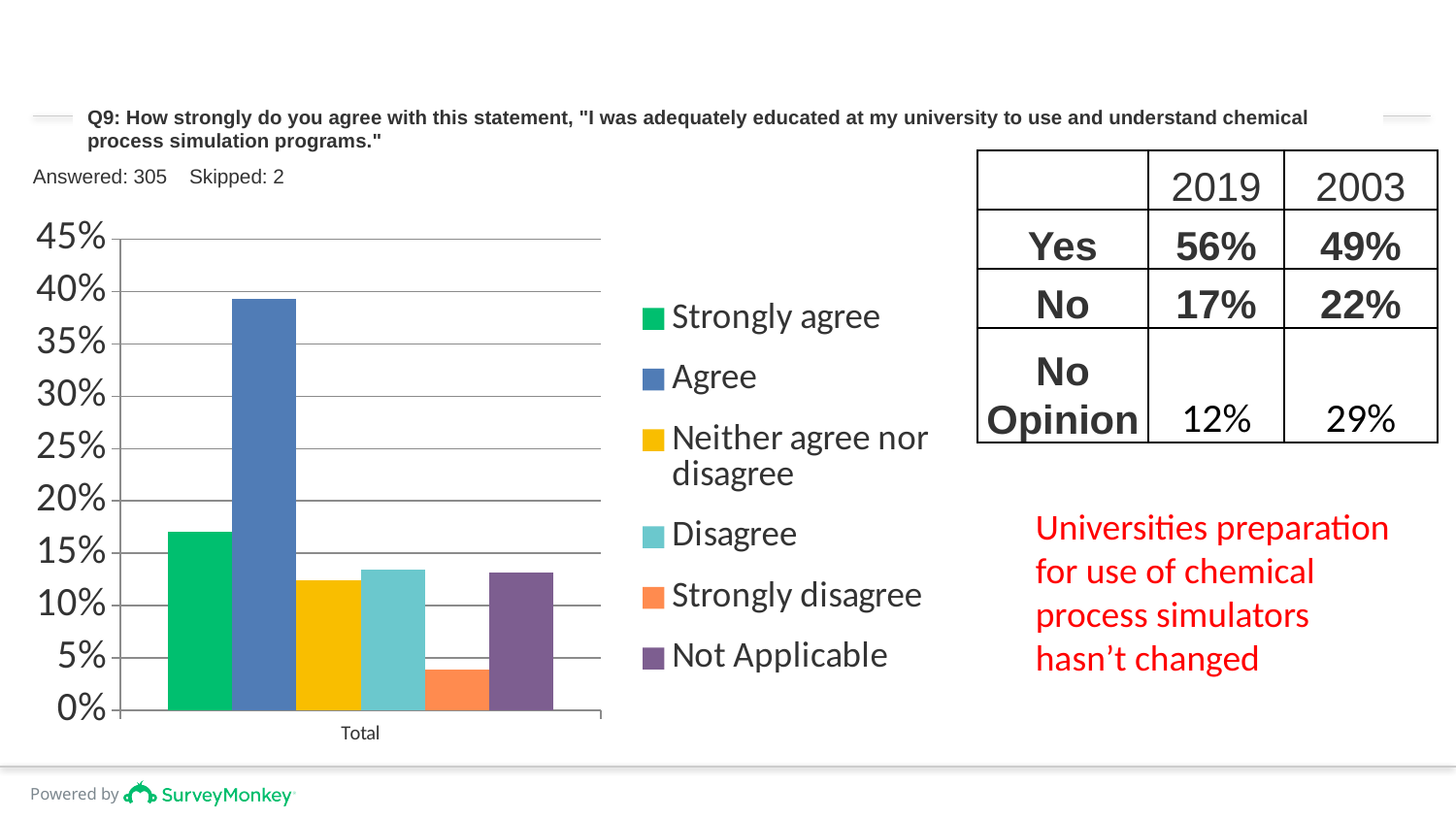
Which series has the shortest bar in the chart? Strongly disagree Is the value for Strongly agree greater or less than 15%? greater How many categories are shown on the x axis of the chart? 1 Which series has the tallest bar in the chart? Agree Which is larger, the bar for Agree or the bar for Strongly agree? Agree Is the value for Agree greater or less than 35%? greater What kind of chart is shown on the slide? bar chart Is the value for Strongly disagree greater or less than 5%? less What colour is the Agree series in the chart legend? blue How many series does the chart legend list? 6